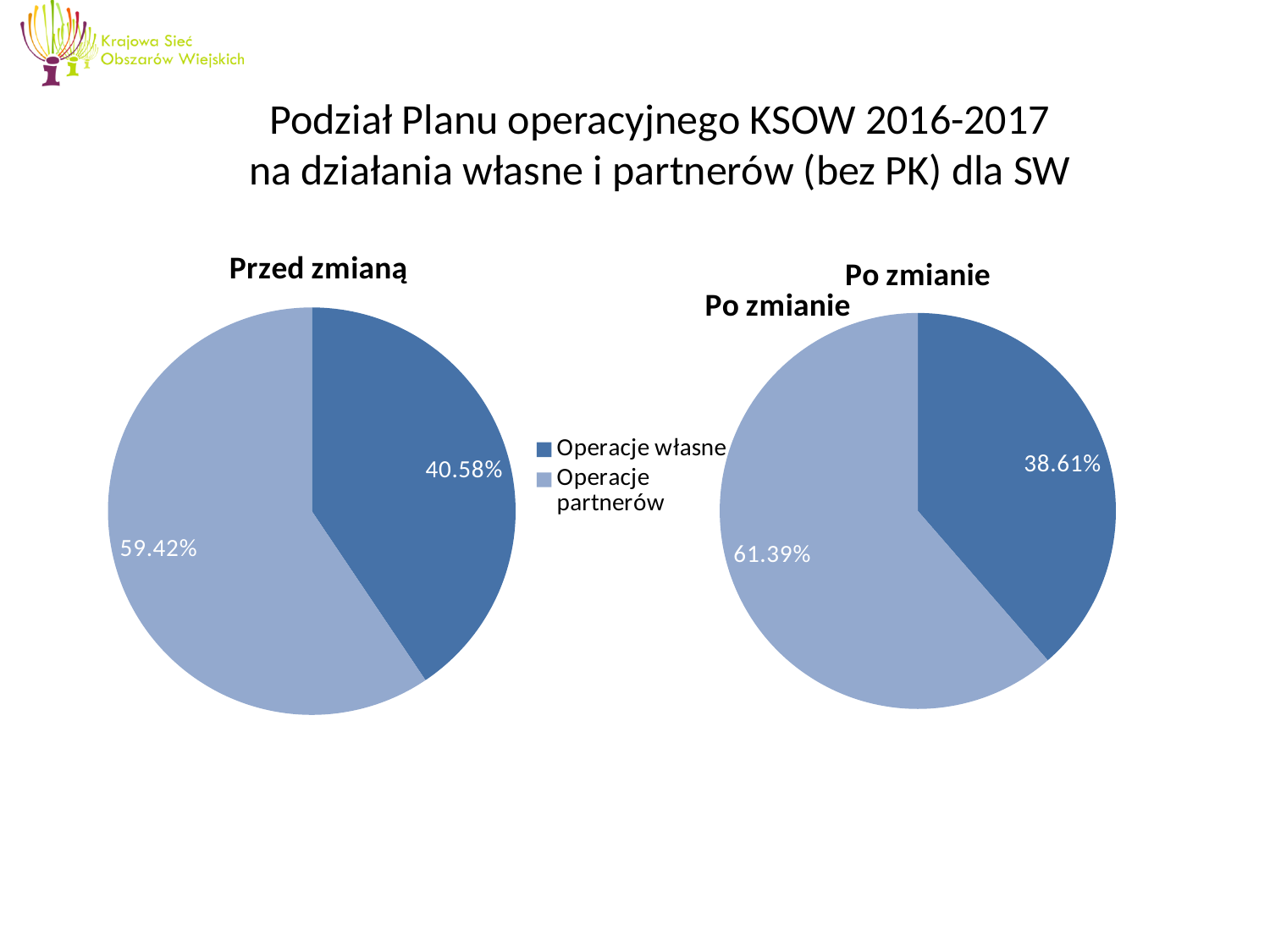
In the 'Po zmianie' pie chart, what share is labelled for Operacje własne? 38.61% In the 'Po zmianie' pie chart, which slice is the smallest? Operacje własne In the 'Po zmianie' pie chart, what share is labelled for Operacje partnerów? 61.39% How many entries does the legend list? 2 In the 'Przed zmianą' pie chart, which slice is the largest? Operacje partnerów In the 'Przed zmianą' pie chart, what share is labelled for Operacje własne? 40.58% In the 'Przed zmianą' pie chart, what share is labelled for Operacje partnerów? 59.42% How many slices does the 'Po zmianie' pie chart have? 2 In the 'Przed zmianą' pie chart, what is the difference between the Operacje partnerów share and the Operacje własne share? 18.84% Which legend entry is shown in the darker blue colour? Operacje własne What type of chart is used for 'Przed zmianą' and 'Po zmianie'? Pie chart Is the share for Operacje własne larger in the 'Przed zmianą' chart or in the 'Po zmianie' chart? Przed zmianą